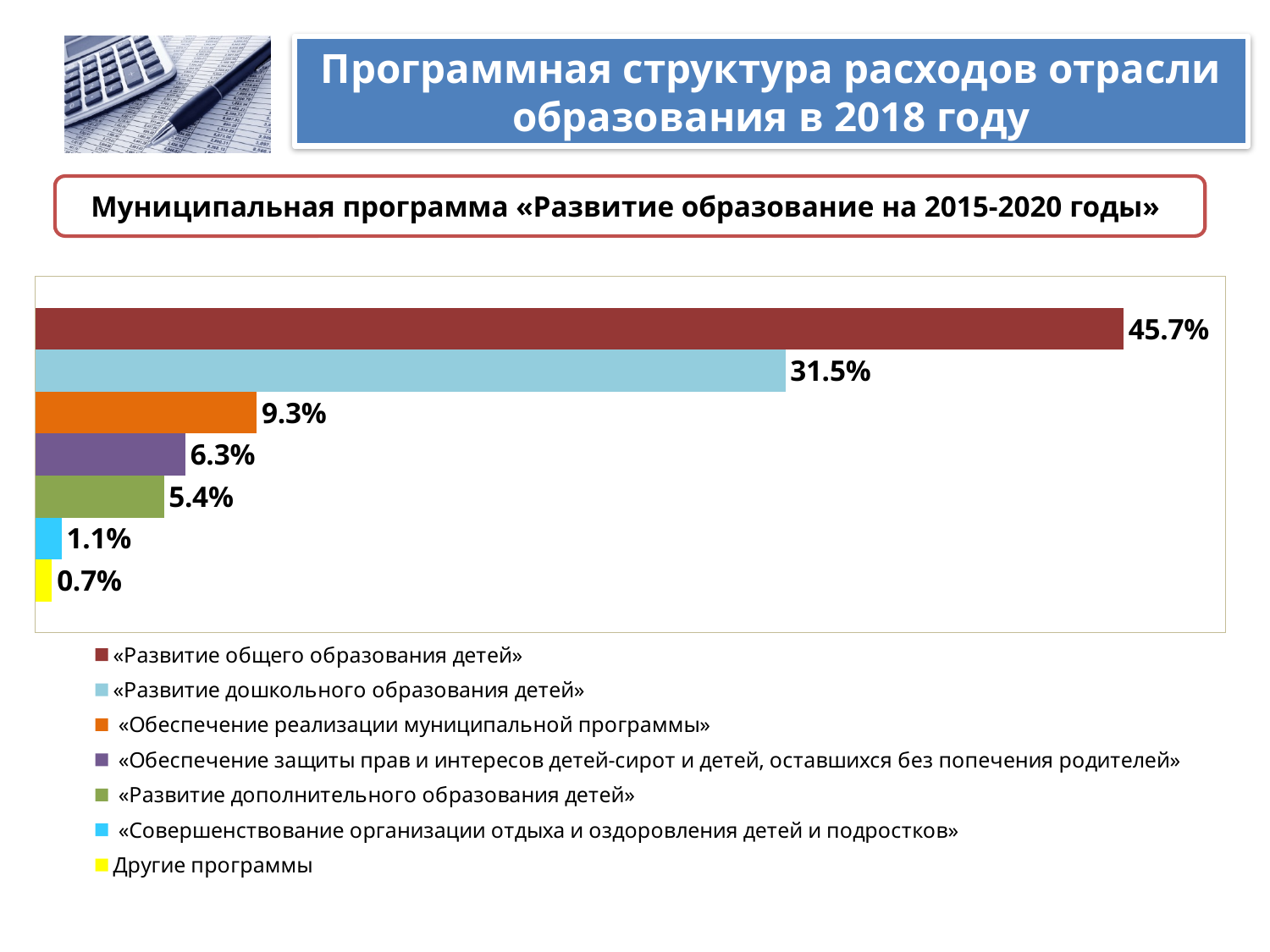
Which is larger: the value for «Обеспечение защиты прав и интересов детей-сирот и детей, оставшихся без попечения родителей» or the value for «Развитие дополнительного образования детей»? «Обеспечение защиты прав и интересов детей-сирот и детей, оставшихся без попечения родителей» How many bars are plotted in the chart? 7 What is the difference between the values for «Развитие общего образования детей» and «Развитие дошкольного образования детей»? 14.2% What is the value for Другие программы? 0.7% What is the value for «Развитие дошкольного образования детей»? 31.5% How many entries does the legend list? 7 What kind of chart is shown on the slide? bar chart What is the value for «Обеспечение реализации муниципальной программы»? 9.3% What is the value for «Развитие дополнительного образования детей»? 5.4% Which category has the highest value? «Развитие общего образования детей» What is the value for «Развитие общего образования детей»? 45.7% Which category has the lowest value? Другие программы